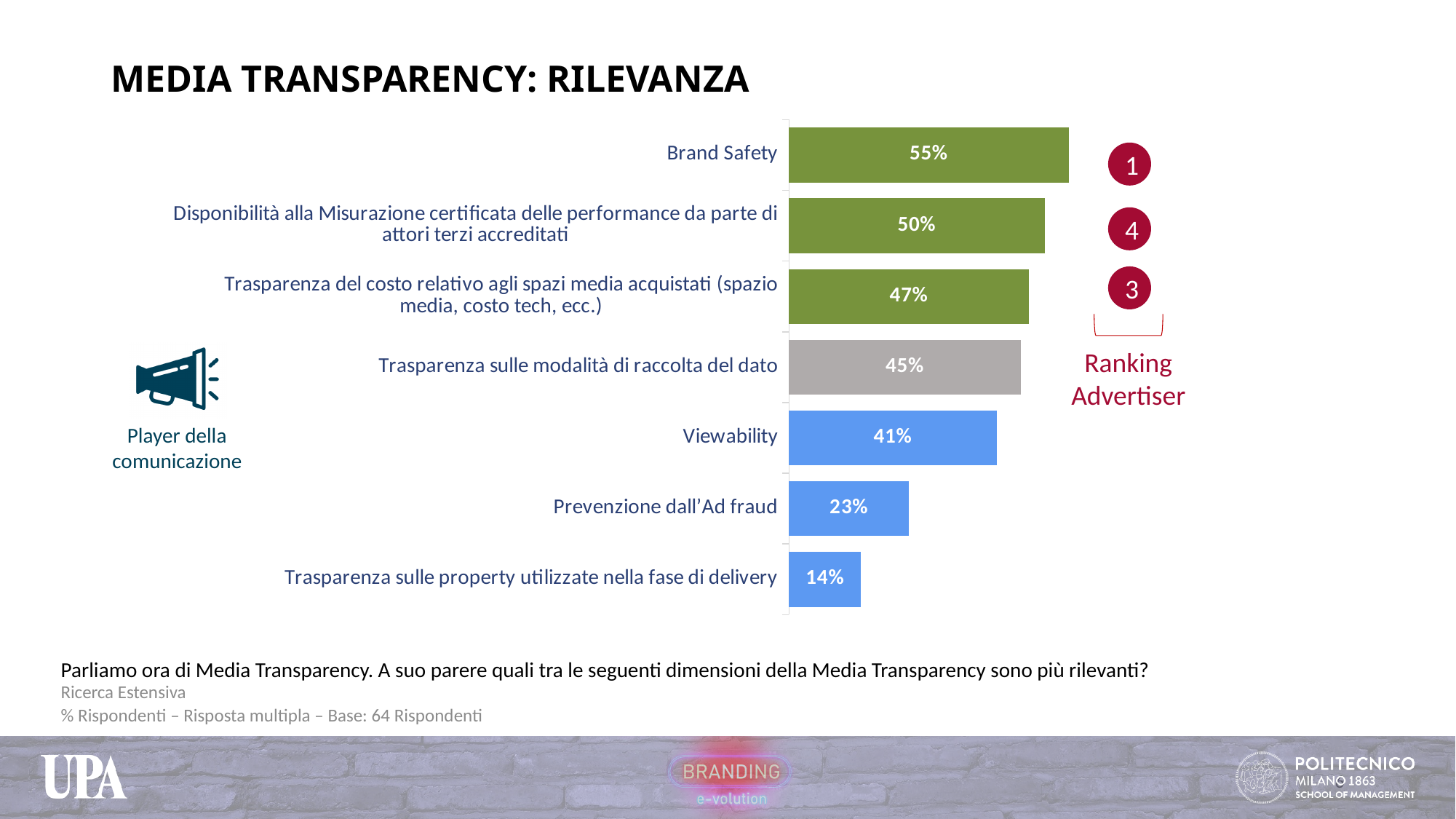
Which category has the highest value? Brand Safety What Ranking Advertiser number is shown next to the Brand Safety bar? 1 What is the title of the slide? MEDIA TRANSPARENCY: RILEVANZA What is the value for Trasparenza sulle modalità di raccolta del dato? 45% What is the value for Viewability? 41% How many categories are shown in the chart? 7 What is the value for Brand Safety? 55% Which category has the lowest value? Trasparenza sulle property utilizzate nella fase di delivery Which is larger, the value for Prevenzione dall'Ad fraud or the value for Trasparenza sulle property utilizzate nella fase di delivery? Prevenzione dall'Ad fraud What kind of chart is shown on the slide? Bar chart What is the difference between the values for Brand Safety and Viewability? 14% What is the value for Prevenzione dall'Ad fraud? 23%